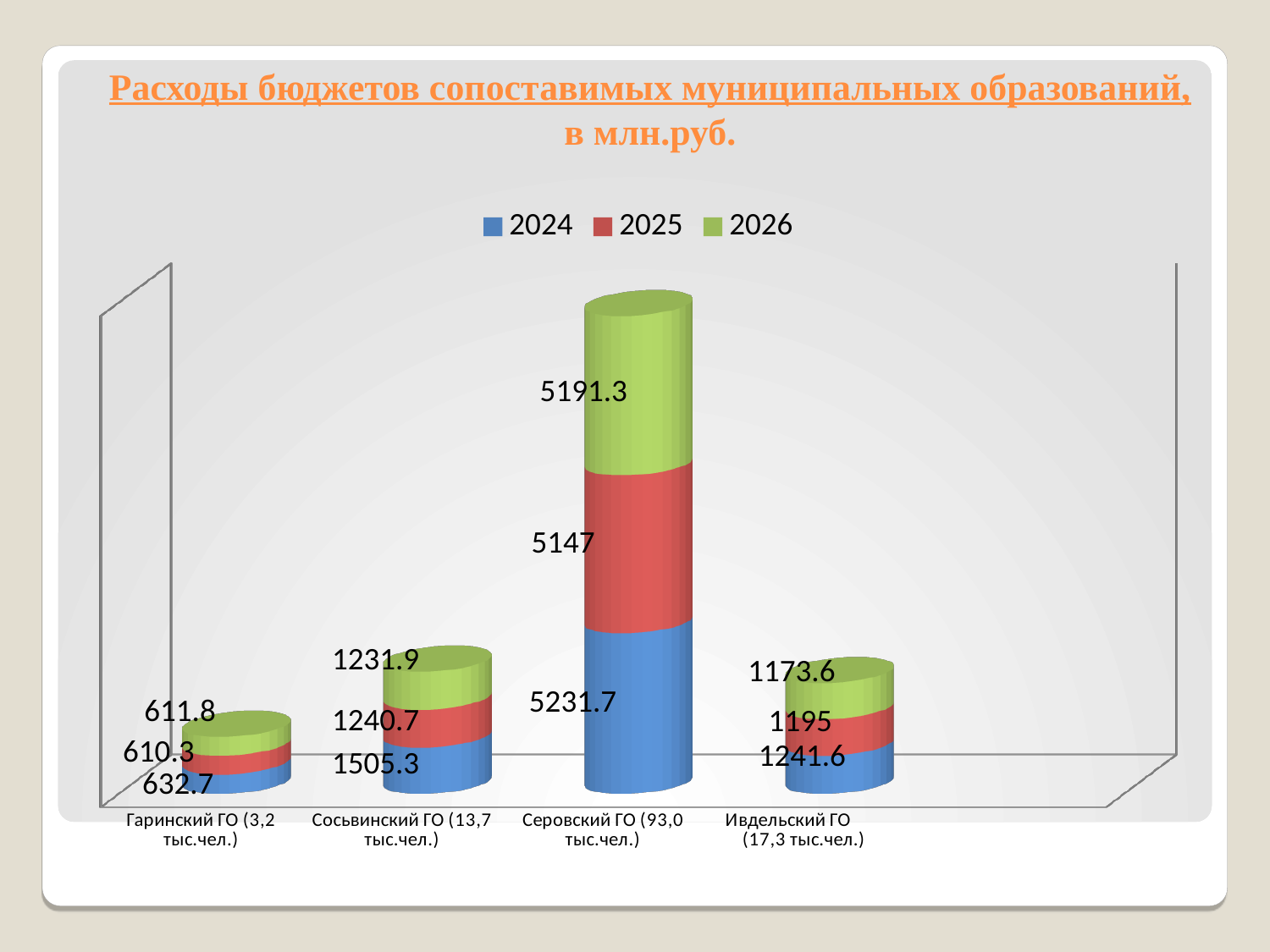
What is the 2025 value for Ивдельский ГО (17,3 тыс.чел.)? 1195 Which municipality has the lowest 2024 value? Гаринский ГО (3,2 тыс.чел.) Which is larger for Ивдельский ГО (17,3 тыс.чел.): the 2024 value or the 2026 value? 2024 How many municipalities are shown on the x axis? 4 What is the 2024 value for Сосьвинский ГО (13,7 тыс.чел.)? 1505.3 What kind of chart is shown on the slide? Stacked bar chart What is the total of the stacked bar for Гаринский ГО (3,2 тыс.чел.)? 1854.8 What is the difference between the 2024 and 2025 values for Сосьвинский ГО (13,7 тыс.чел.)? 264.6 Which municipality has the highest 2025 value? Серовский ГО (93,0 тыс.чел.) What is the 2026 value for Гаринский ГО (3,2 тыс.чел.)? 611.8 How many series does the legend list? 3 What is the 2024 value for Серовский ГО (93,0 тыс.чел.)? 5231.7